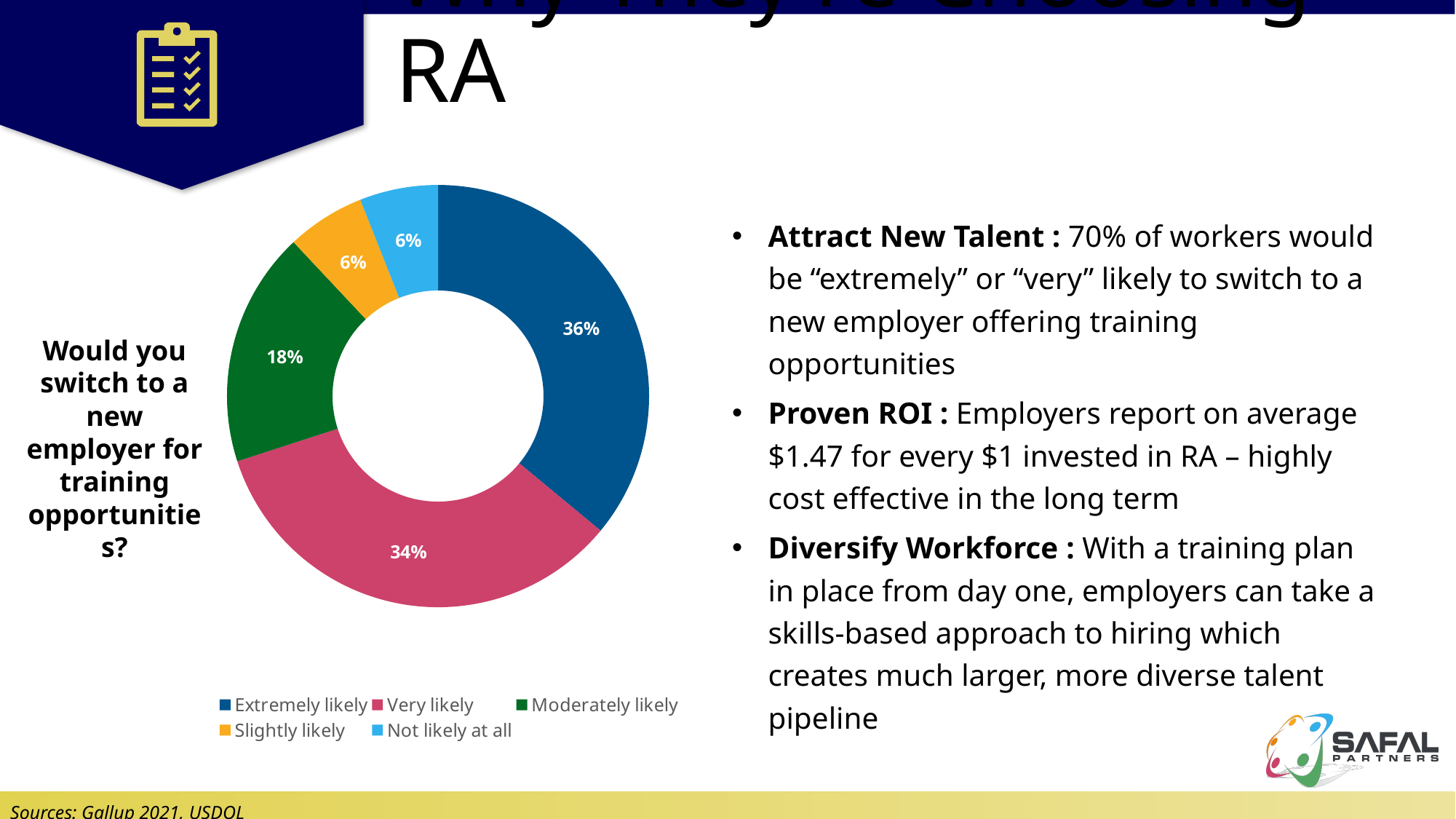
What kind of chart is shown on the slide? doughnut chart What percentage is shown for "Moderately likely"? 18% What is the combined share of "Extremely likely" and "Very likely"? 70% Which is larger, the share for "Moderately likely" or the share for "Slightly likely"? Moderately likely Which category has the largest share of the chart? Extremely likely What percentage is shown for "Very likely"? 34% What is the difference in percentage points between "Extremely likely" and "Very likely"? 2 percentage points What question does the chart's title ask? Would you switch to a new employer for training opportunities? What percentage is shown for "Not likely at all"? 6% Which two categories share the smallest slice of the chart? Slightly likely and Not likely at all How many categories does the chart show? 5 What percentage of respondents said they would be "Extremely likely" to switch to a new employer for training opportunities? 36%